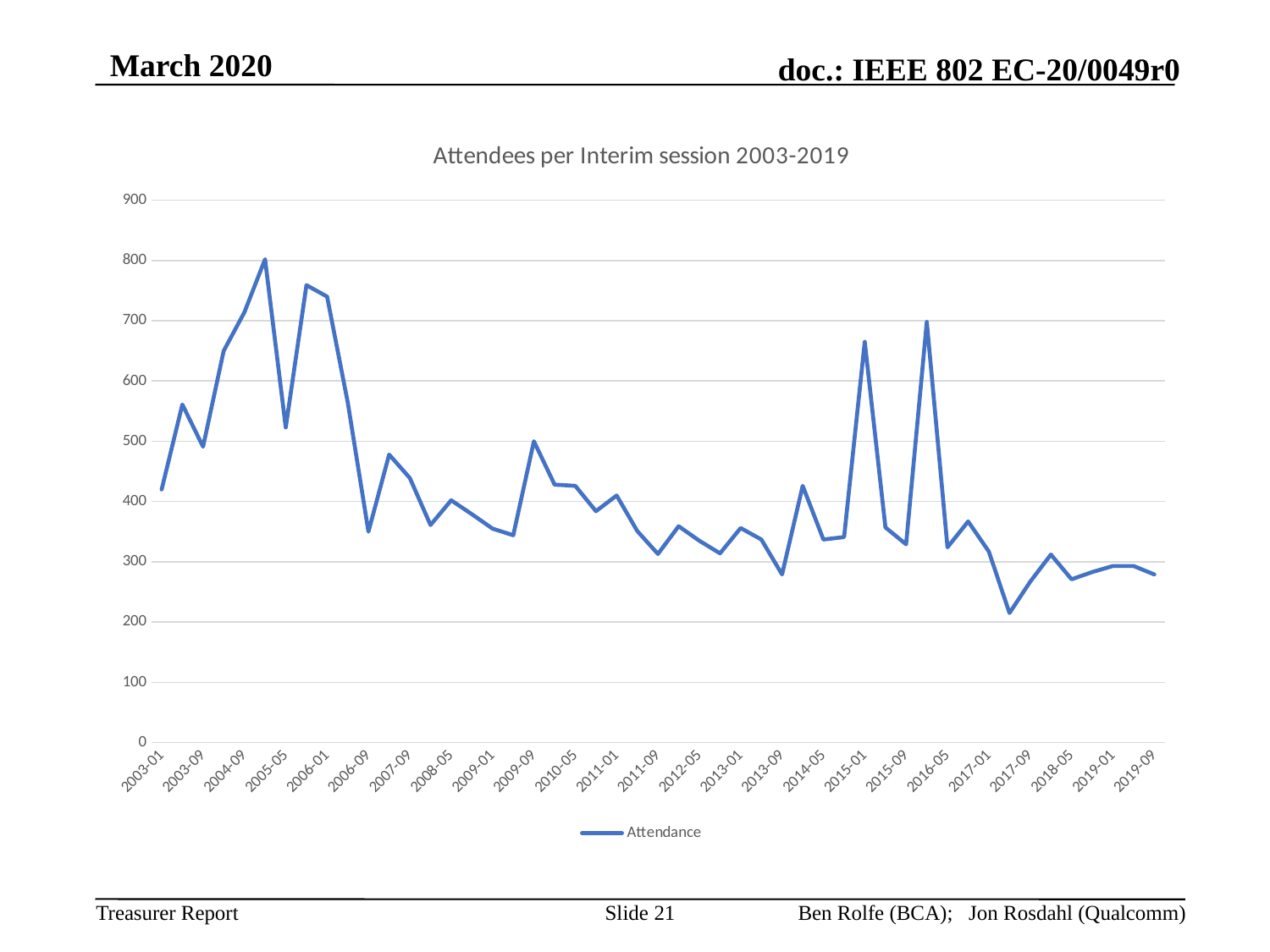
How many series does the legend list? 1 Overall, do the values rise or fall from 2003-01 to 2019-09? fall Is the value for 2017-09 greater or less than 300? less Is the value for 2015-01 greater or less than 600? greater What is the name of the series shown in the legend? Attendance Is the value for 2019-09 greater or less than 300? less What is the title of the chart? Attendees per Interim session 2003-2019 What kind of chart is shown on the slide? line chart Which is larger, the value for 2003-01 or the value for 2019-09? 2003-01